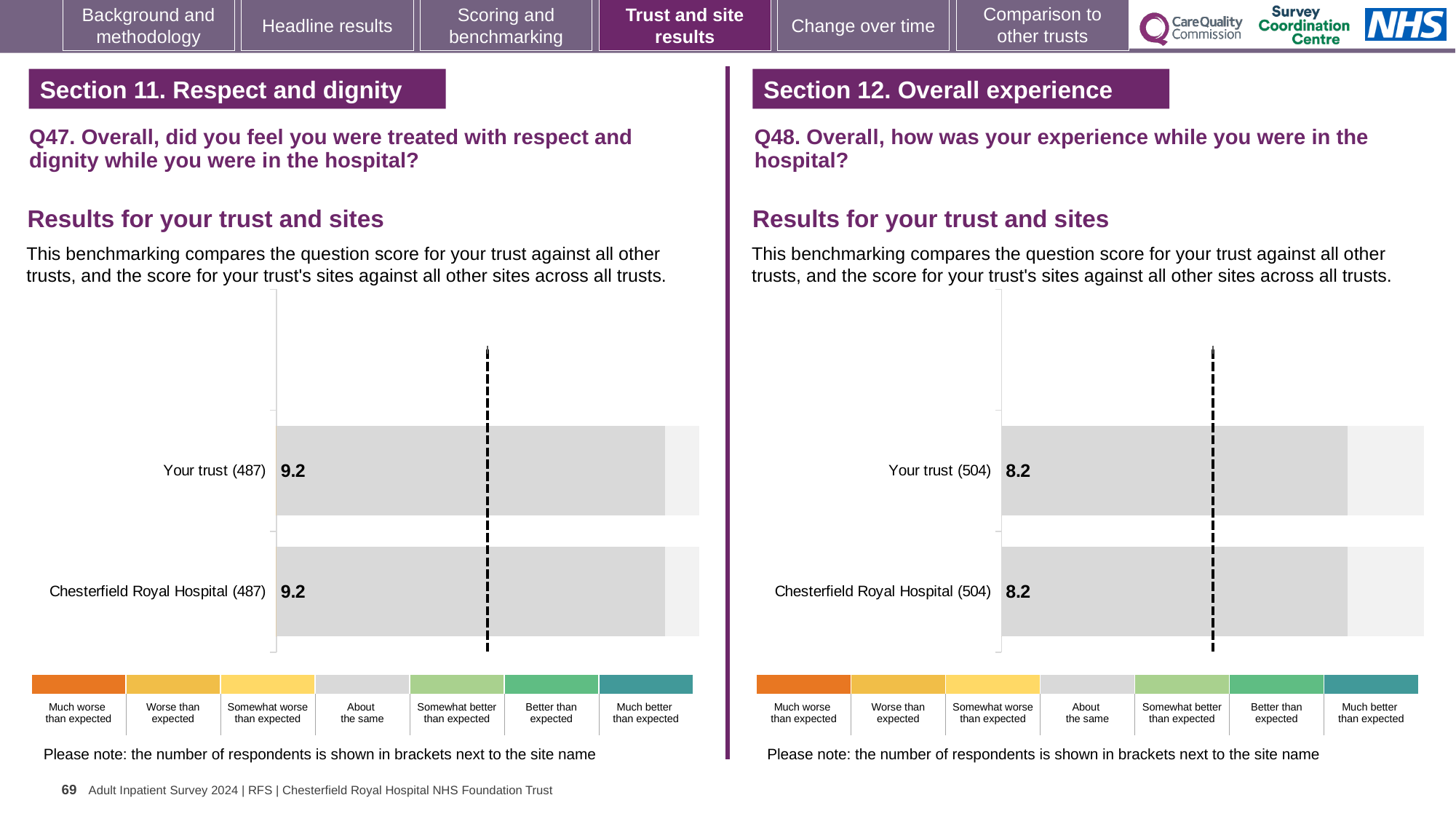
What kind of chart is used on the left (Q47)? Bar chart On the right chart (Q48, overall experience), what is the score for Your trust? 8.2 On the right chart (Q48, overall experience), what is the score for Chesterfield Royal Hospital? 8.2 On the left chart (Q47, respect and dignity), what is the score for Your trust? 9.2 How many bars are plotted on the right chart (Q48)? 2 On the left chart (Q47), how many respondents are shown in brackets next to Your trust? 487 What is the difference between the Your trust score on the left chart (Q47) and the Your trust score on the right chart (Q48)? 1.0 On the left chart (Q47, respect and dignity), what is the score for Chesterfield Royal Hospital? 9.2 On the right chart (Q48), how many respondents are shown in brackets next to Chesterfield Royal Hospital? 504 Which is larger: the Your trust score on the left chart (Q47) or the Your trust score on the right chart (Q48)? Left chart (Q47) How many bars are plotted on the left chart (Q47)? 2